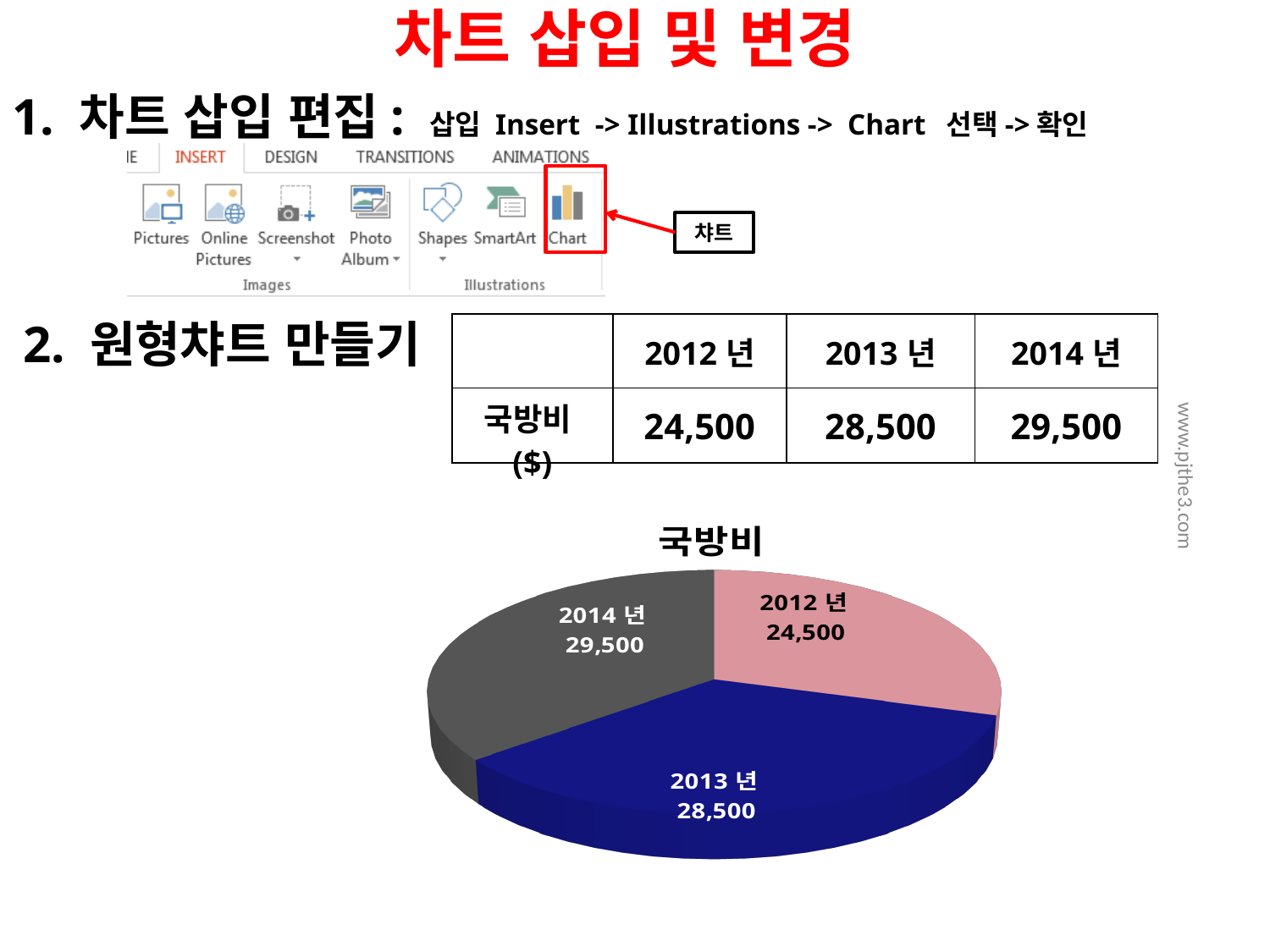
Which year has the largest slice in the pie chart? 2014 년 What is the value shown for 2013 년 in the pie chart? 28,500 Which is larger, the value for 2013 년 or the value for 2012 년? 2013 년 What type of chart is shown on the slide? Pie chart What is the difference between the values for 2013 년 and 2012 년? 4,000 What is the title of the pie chart? 국방비 What is the value shown for 2012 년 in the pie chart? 24,500 How many slices does the pie chart have? 3 Which year has the smallest slice in the pie chart? 2012 년 What colour is the 2013 년 slice in the pie chart? Dark blue What is the value shown for 2014 년 in the pie chart? 29,500 What is the difference between the values for 2014 년 and 2012 년? 5,000